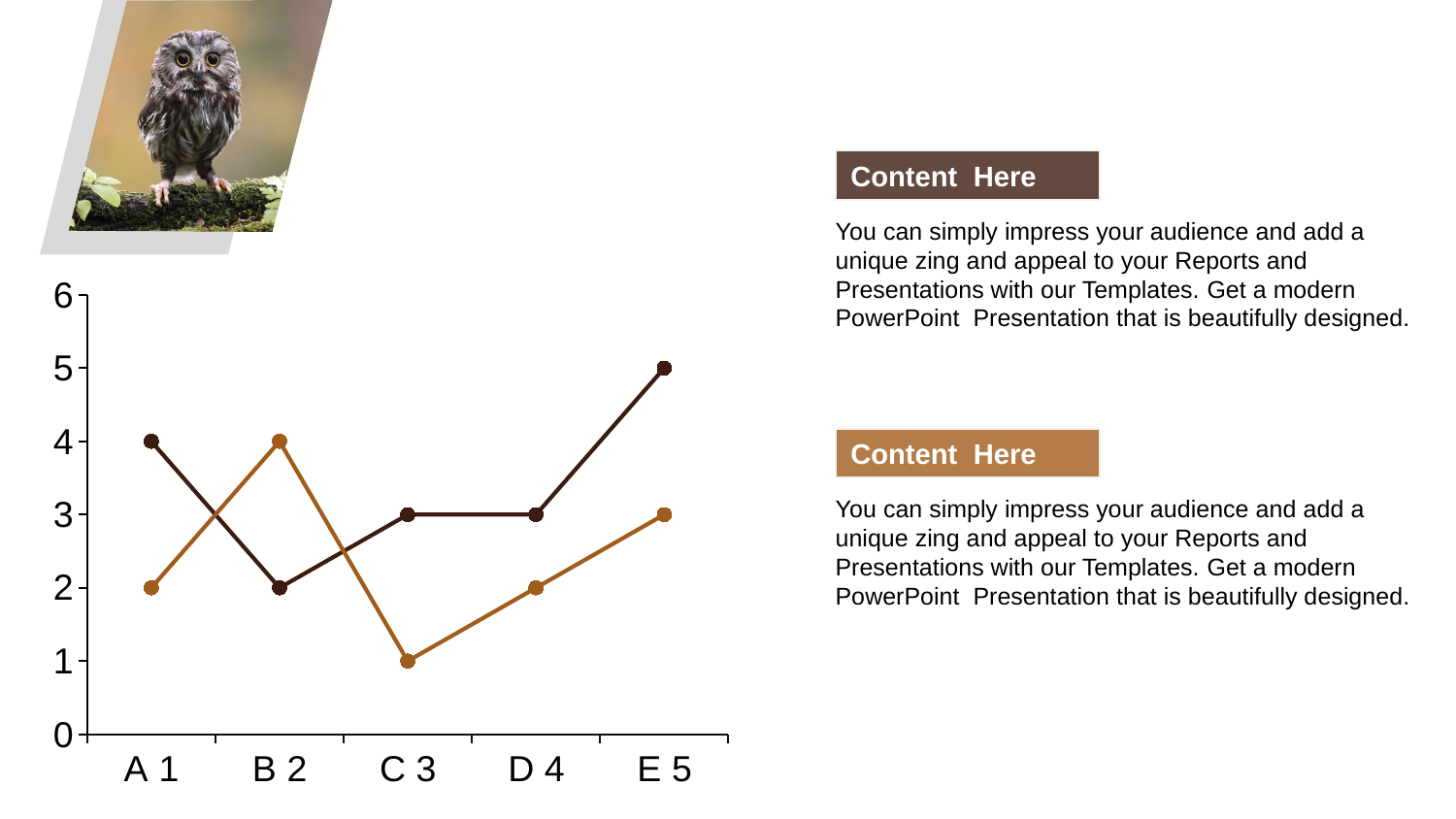
What is the value of the orange line at C 3? 1 What is the value of the orange line at B 2? 4 At which category does the dark brown line reach its highest value? E 5 How many categories are shown on the x axis of the chart? 5 What kind of chart is shown on the slide? line chart What is the highest value shown on the vertical axis of the chart? 6 Does the dark brown line rise or fall from D 4 to E 5? rise What is the value of the dark brown line at A 1? 4 What is the difference between the dark brown line and the orange line at E 5? 2 What is the value of the dark brown line at E 5? 5 At which category does the orange line reach its lowest value? C 3 At B 2, which line has the higher value, the dark brown line or the orange line? the orange line